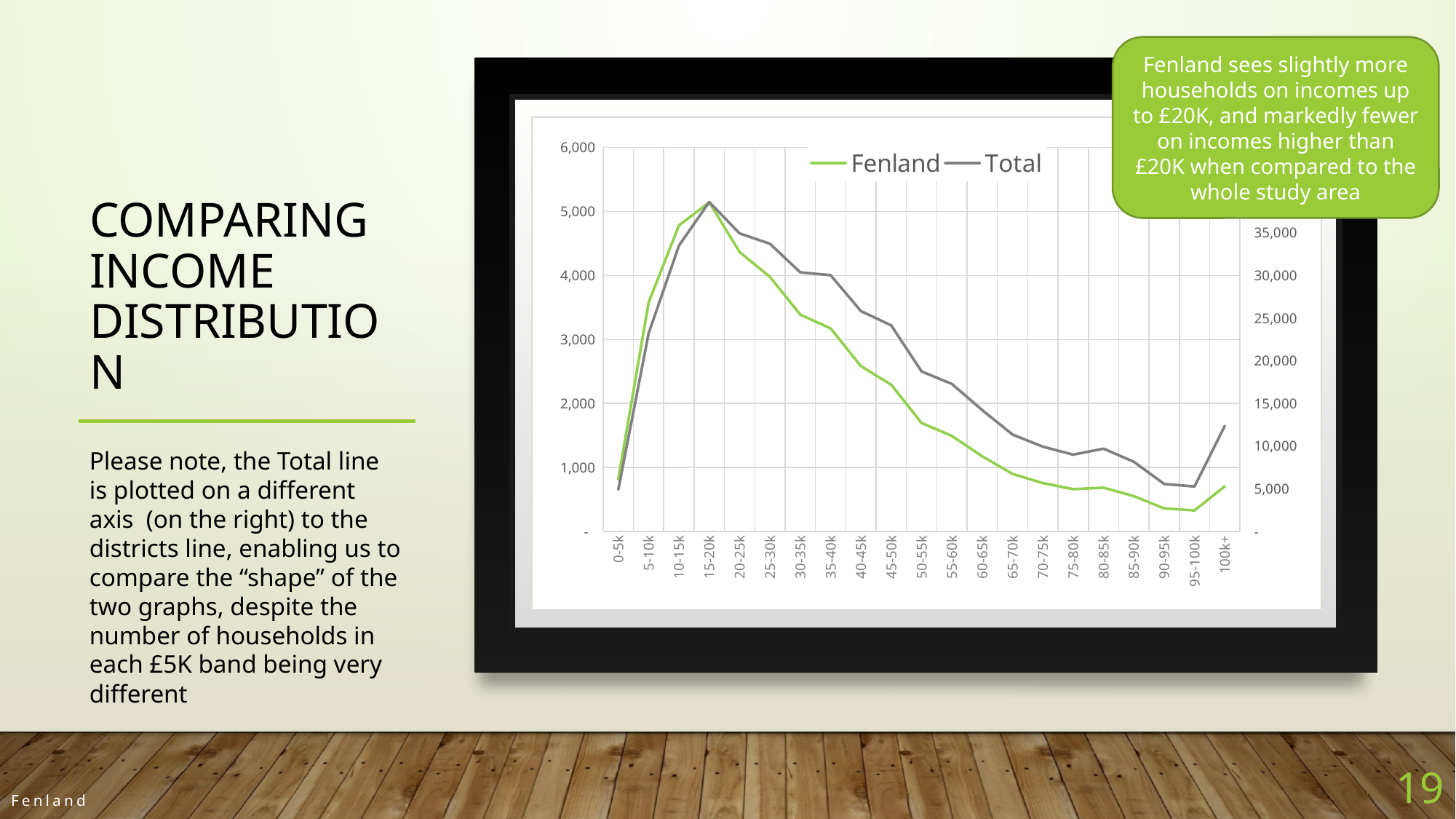
Is the Fenland value for 50-55k greater or less than 2,000? less In which income band does the Total line reach its highest value? 15-20k How many series does the chart legend list? 2 In which income band does the Fenland line reach its highest value? 15-20k Which is larger for Fenland: the value for 20-25k or the value for 40-45k? 20-25k In which income band is the Fenland line at its lowest value? 95-100k How many income bands are plotted along the x axis? 21 Is the Fenland value for 5-10k greater or less than 3,000? greater Is the Fenland value for 10-15k greater or less than 5,000? less Does the Fenland line rise or fall between 15-20k and 95-100k? Fall What kind of chart is shown on the slide? Line chart